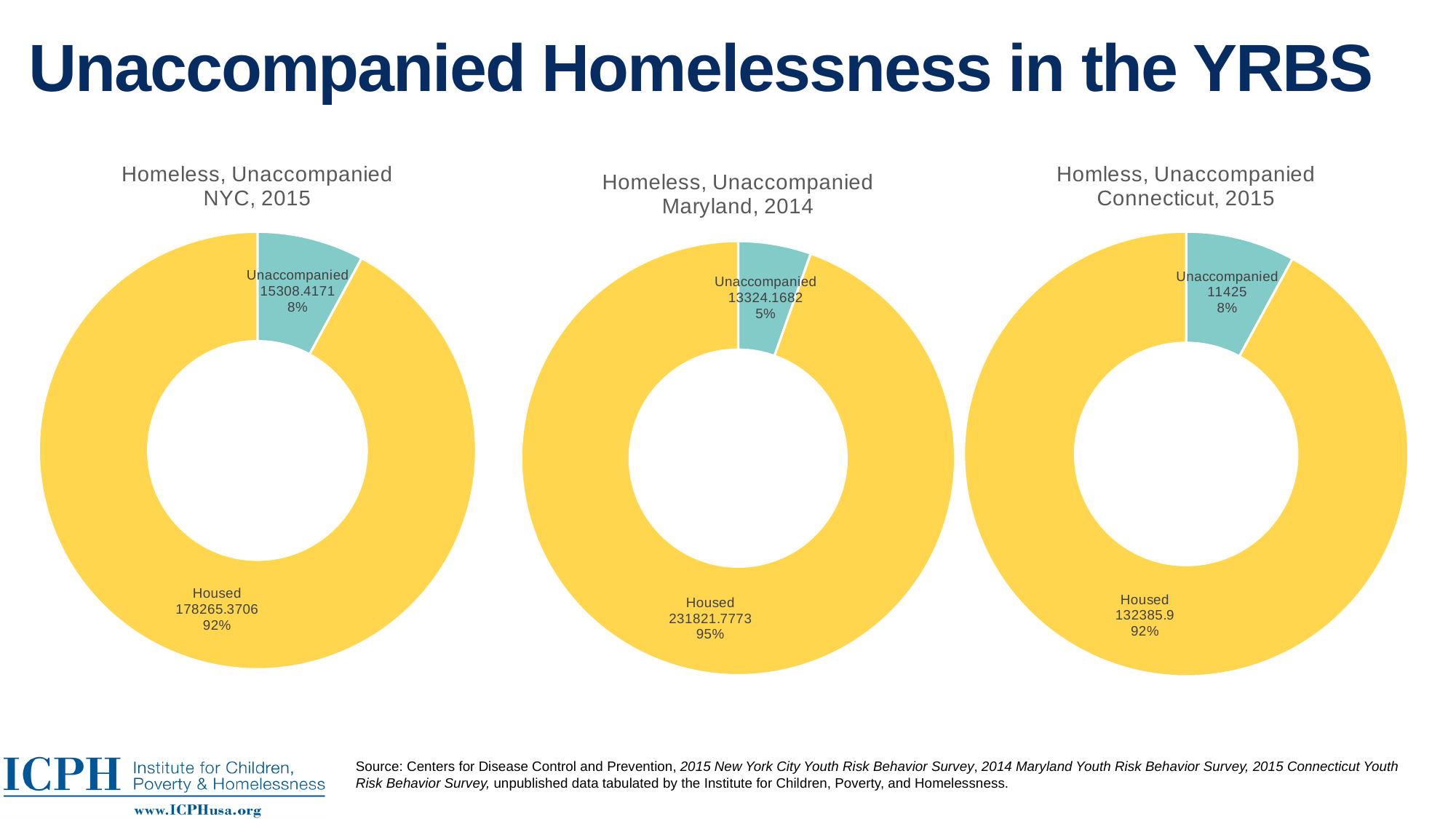
In the NYC, 2015 chart, what value is shown for Unaccompanied? 15308.4171 In the Maryland, 2014 chart, what share of the pie is Unaccompanied? 5% In the NYC, 2015 chart, what share of the pie is Unaccompanied? 8% In the Connecticut, 2015 chart, what value is shown for Unaccompanied? 11425 Across the three charts, which one shows the smallest Unaccompanied share? Maryland, 2014 In the Connecticut, 2015 chart, what share of the pie is Housed? 92% In the Connecticut, 2015 chart, what is the difference between the Housed and Unaccompanied values? 120960.9 What kind of chart is used for the NYC, 2015 data? Pie (donut) chart In the NYC, 2015 chart, what value is shown for Housed? 178265.3706 In the Maryland, 2014 chart, which is larger, Housed or Unaccompanied? Housed In the Maryland, 2014 chart, what value is shown for Housed? 231821.7773 How many slices does the Maryland, 2014 chart have? 2